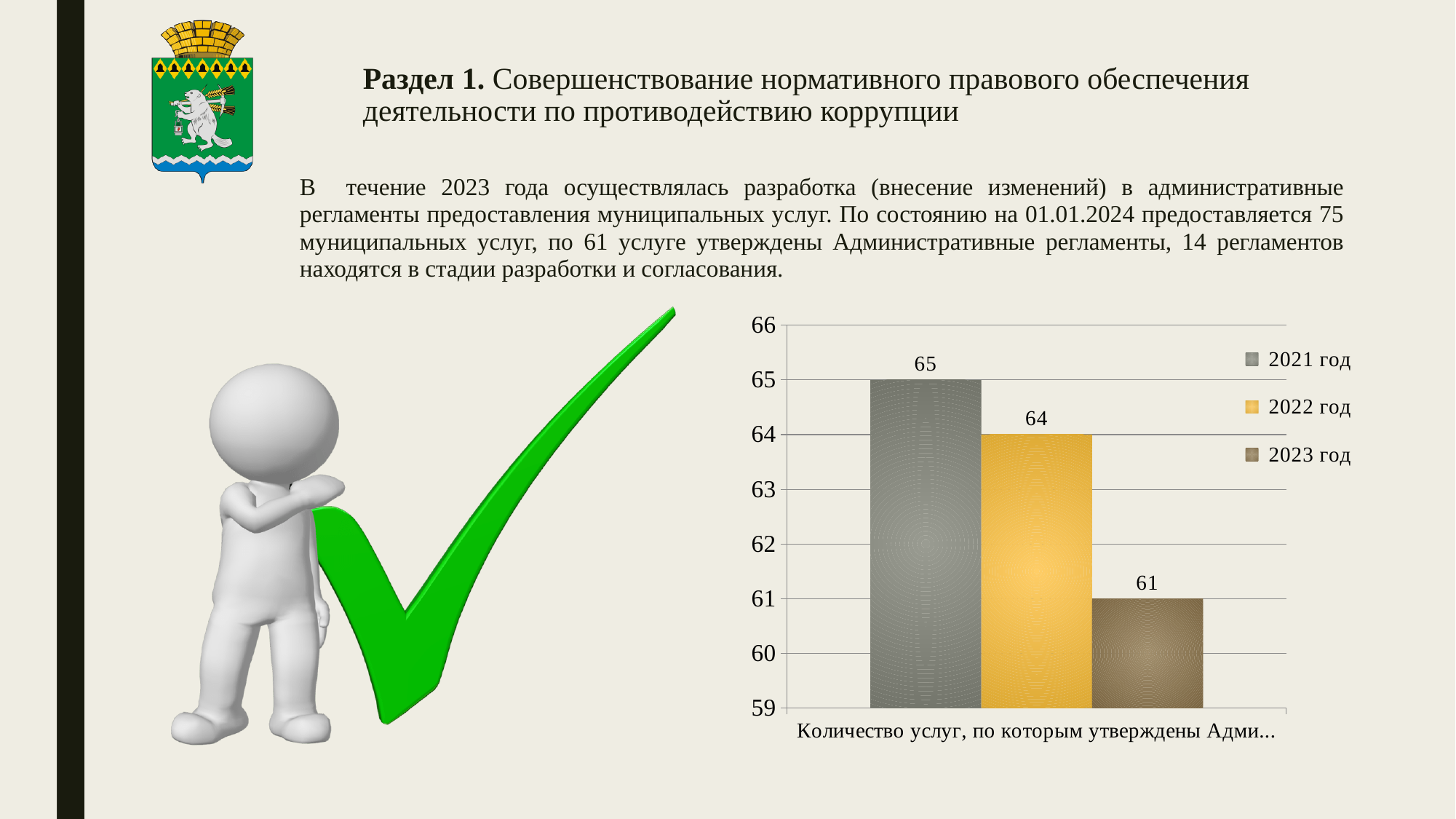
What kind of chart is shown on the slide? bar chart Which is larger, the value for 2021 год or the value for 2022 год? 2021 год How many series does the legend list? 3 What is the value for 2023 год in the chart? 61 What is the value for 2022 год in the chart? 64 Which series has the highest value in the chart? 2021 год Is the value for 2023 год greater or less than 62? less What is the difference between the values for 2021 год and 2023 год? 4 Do the values rise or fall from 2021 год to 2023 год? fall What is the value for 2021 год in the chart? 65 Which series has the lowest value in the chart? 2023 год What is the difference between the values for 2022 год and 2023 год? 3